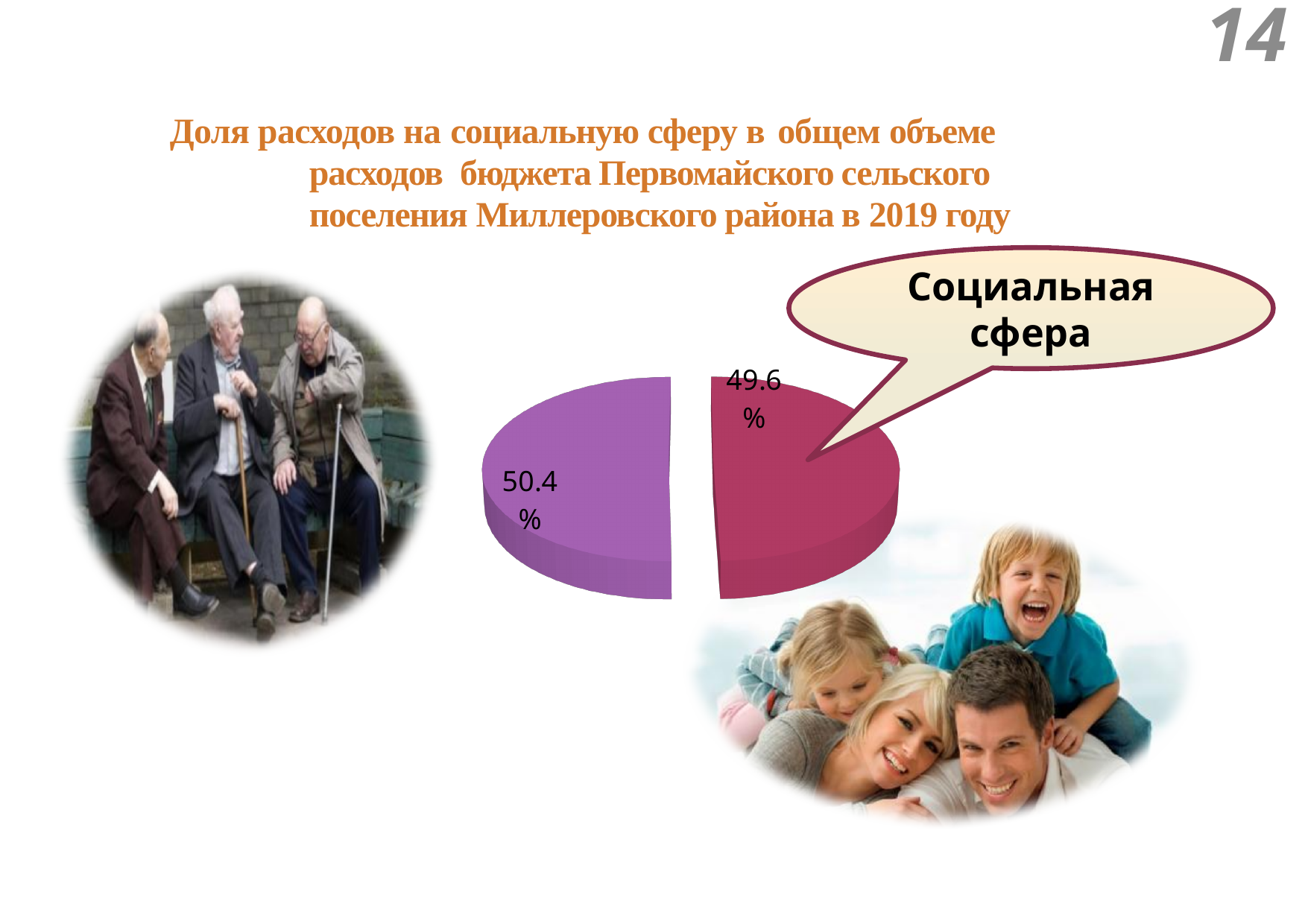
For which year does the slide title say the share of social sphere expenditures is shown? 2019 What is the total of the two slice values shown on the pie chart? 100% What value is shown on the purple slice of the pie chart? 50.4% What colour is the slice labelled "Социальная сфера"? magenta (crimson) What is the largest value shown on the pie chart? 50.4% How many slices does the pie chart have? 2 Which slice of the pie chart is larger: the one labelled "Социальная сфера" or the purple slice? the purple slice What is the smallest value shown on the pie chart? 49.6% Is the share for "Социальная сфера" greater or less than 50%? less What kind of chart is shown on the slide? pie chart What is the difference between the two slice values on the pie chart? 0.8% What share of budget expenditures does the slice labelled "Социальная сфера" represent? 49.6%